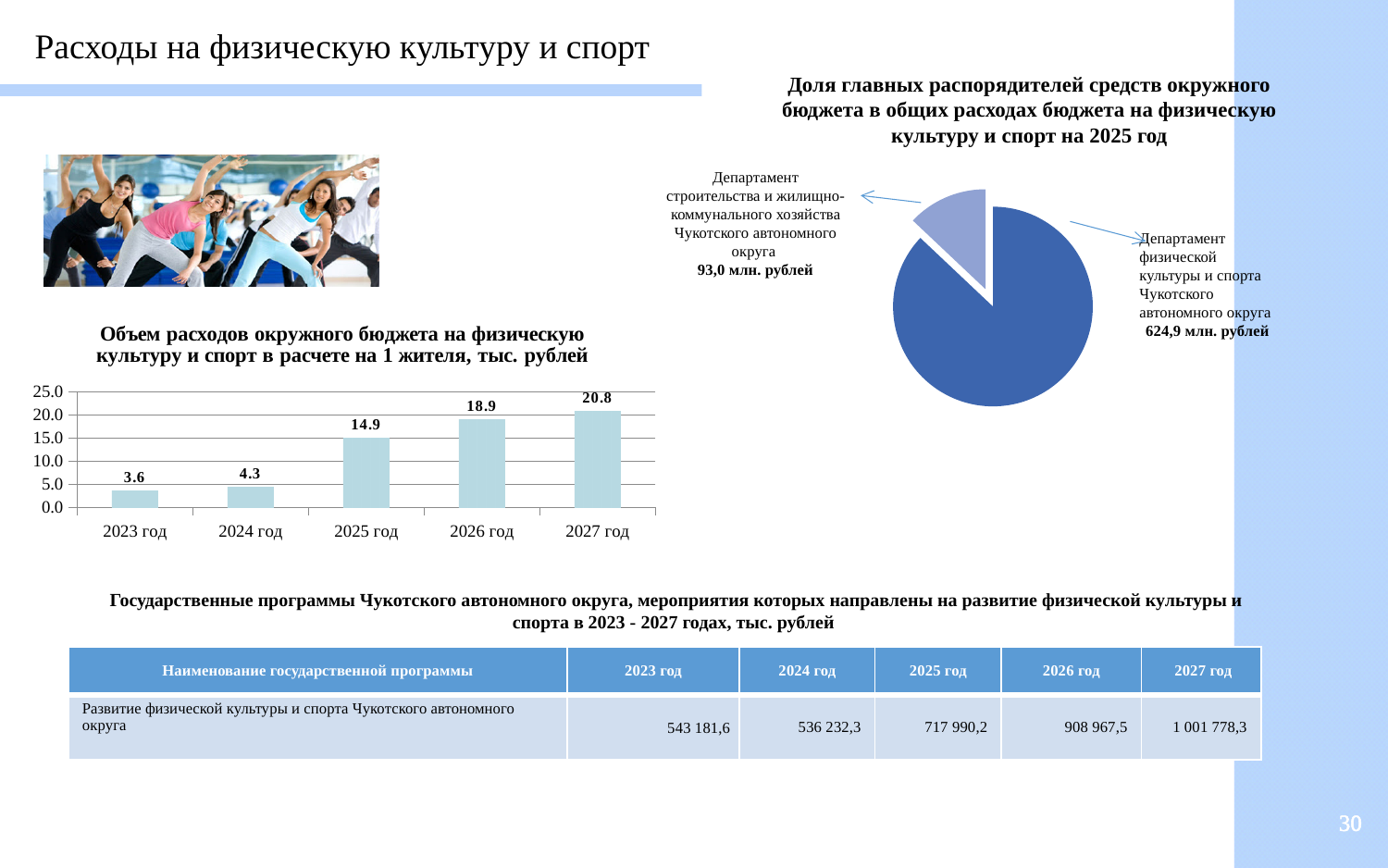
In the bar chart 'Объем расходов окружного бюджета на физическую культуру и спорт в расчете на 1 жителя, тыс. рублей', which is larger: the value for 2024 год or 2026 год? 2026 год In the bar chart 'Объем расходов окружного бюджета на физическую культуру и спорт в расчете на 1 жителя, тыс. рублей', what is the difference between the values for 2026 год and 2025 год? 4.0 In the bar chart 'Объем расходов окружного бюджета на физическую культуру и спорт в расчете на 1 жителя, тыс. рублей', do the values rise or fall from 2023 год to 2027 год? rise In the bar chart 'Объем расходов окружного бюджета на физическую культуру и спорт в расчете на 1 жителя, тыс. рублей', what is the value for 2025 год? 14.9 In the bar chart 'Объем расходов окружного бюджета на физическую культуру и спорт в расчете на 1 жителя, тыс. рублей', which year has the lowest value? 2023 год In the bar chart 'Объем расходов окружного бюджета на физическую культуру и спорт в расчете на 1 жителя, тыс. рублей', which year has the highest value? 2027 год In the pie chart 'Доля главных распорядителей средств окружного бюджета в общих расходах бюджета на физическую культуру и спорт на 2025 год', what is the value for Департамент физической культуры и спорта Чукотского автономного округа? 624,9 млн. рублей What kind of chart is the chart titled 'Объем расходов окружного бюджета на физическую культуру и спорт в расчете на 1 жителя, тыс. рублей'? bar chart In the pie chart 'Доля главных распорядителей средств окружного бюджета в общих расходах бюджета на физическую культуру и спорт на 2025 год', which department has the larger slice? Департамент физической культуры и спорта Чукотского автономного округа In the bar chart 'Объем расходов окружного бюджета на физическую культуру и спорт в расчете на 1 жителя, тыс. рублей', how many years are shown? 5 In the bar chart 'Объем расходов окружного бюджета на физическую культуру и спорт в расчете на 1 жителя, тыс. рублей', what is the value for 2023 год? 3.6 In the bar chart 'Объем расходов окружного бюджета на физическую культуру и спорт в расчете на 1 жителя, тыс. рублей', what is the difference between the values for 2027 год and 2023 год? 17.2